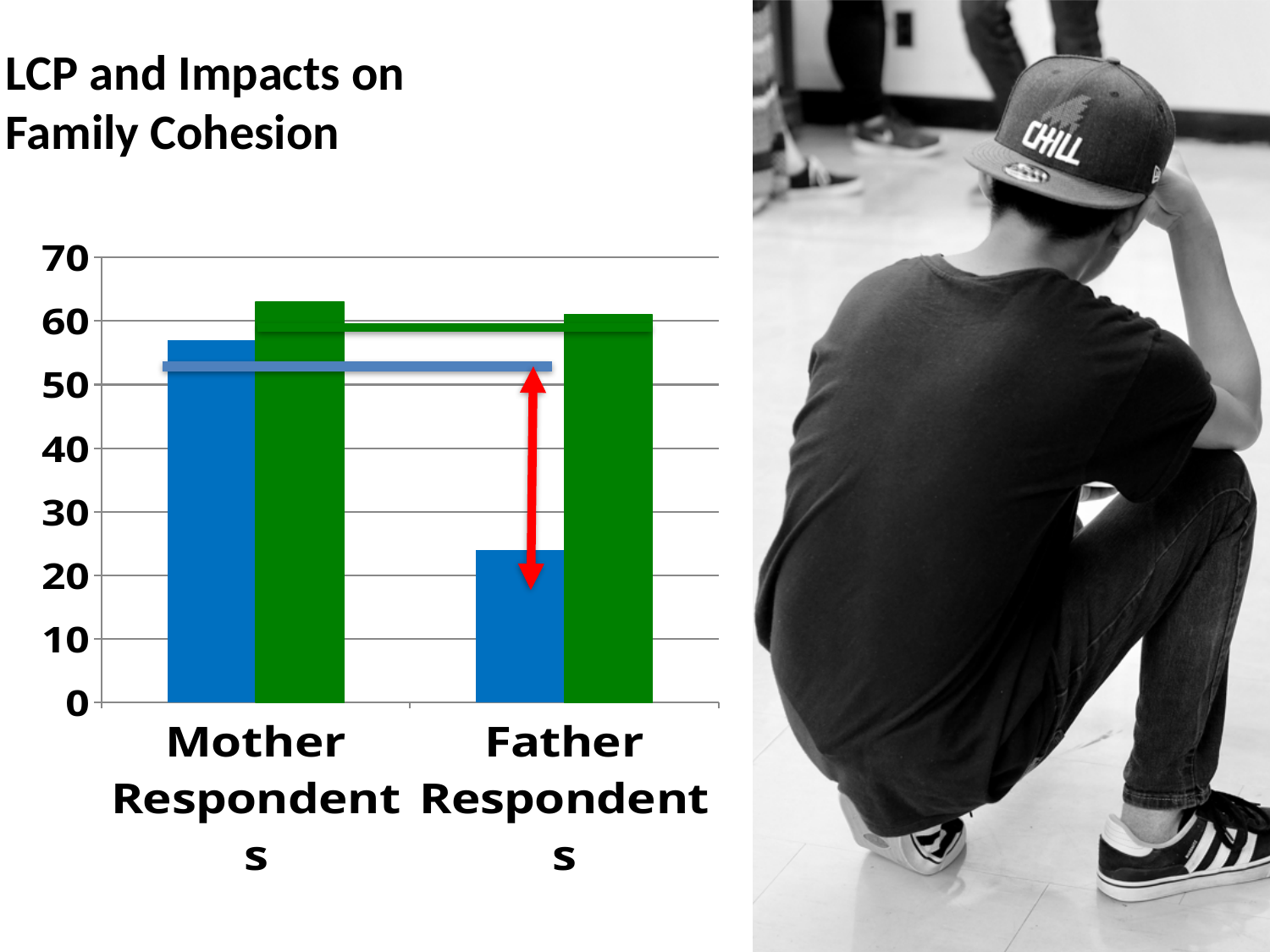
Is the value of the blue bar for Father Respondents greater or less than 30? less Is the value of the blue bar for Mother Respondents greater or less than 50? greater How many bars are plotted in the chart in total? 4 What is the title shown at the top of the slide? LCP and Impacts on Family Cohesion How many categories are shown on the x axis of the chart? 2 Is the value of the green bar for Father Respondents greater or less than 50? greater What kind of chart is shown on the slide? bar chart Which category has the larger blue bar, Mother Respondents or Father Respondents? Mother Respondents Which category has the lowest bar in the chart? Father Respondents For Father Respondents, which bar is taller, the blue bar or the green bar? the green bar